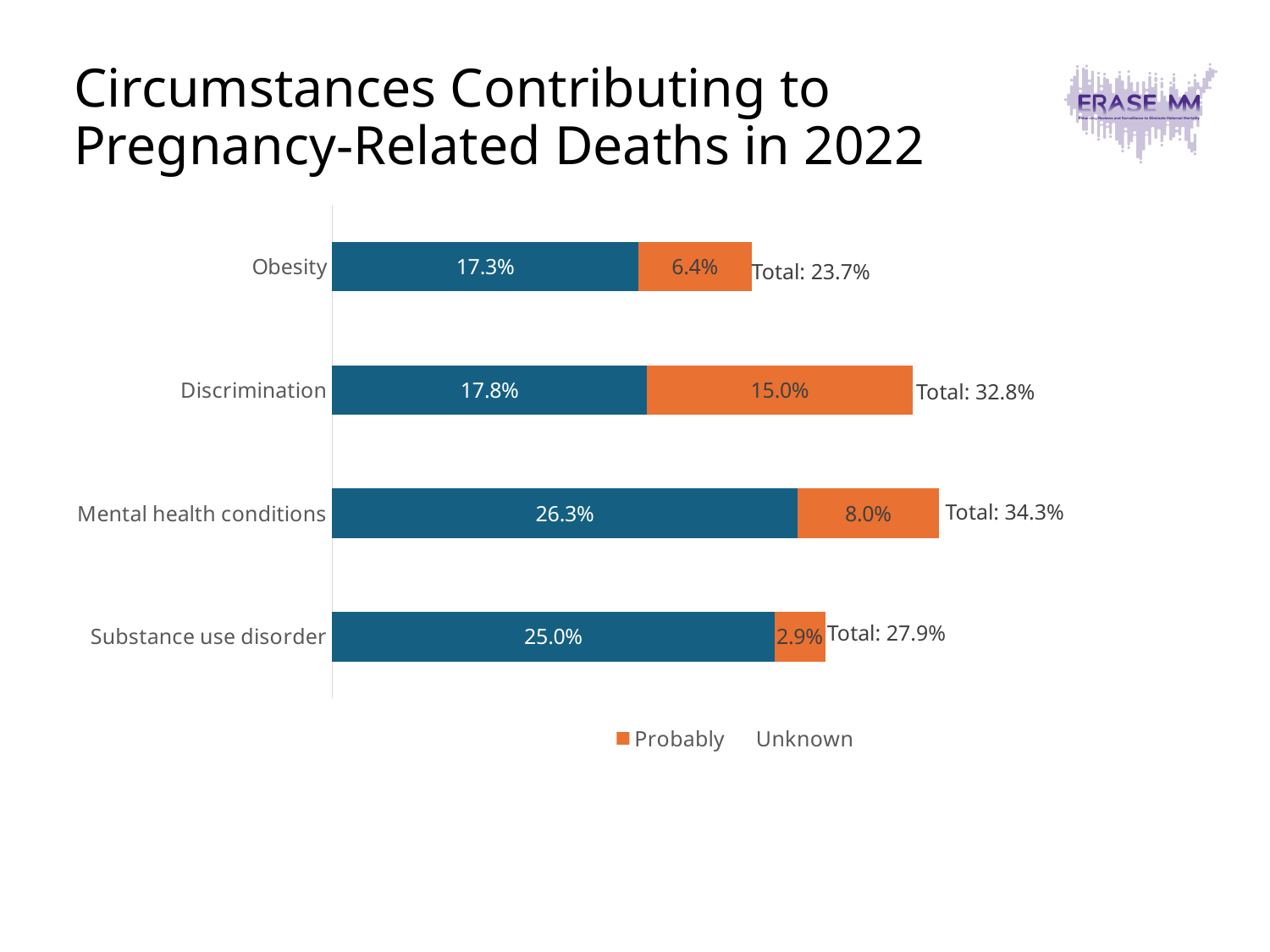
What is the total percentage shown for Discrimination? 32.8% What is the difference between the blue segment values for Substance use disorder and Obesity? 7.7% Which circumstance has the highest total percentage? Mental health conditions Which has the larger orange segment value, Discrimination or Obesity? Discrimination What is the difference between the total for Mental health conditions and the total for Obesity? 10.6% How many categories (circumstances) are plotted in the chart? 4 What value is printed on the blue segment of the Mental health conditions bar? 26.3% What value is printed on the orange segment of the Substance use disorder bar? 2.9% What kind of chart is shown on the slide? Stacked horizontal bar chart What is the title of the slide containing the chart? Circumstances Contributing to Pregnancy-Related Deaths in 2022 How many series does the chart legend list? 2 Which circumstance has the lowest total percentage? Obesity